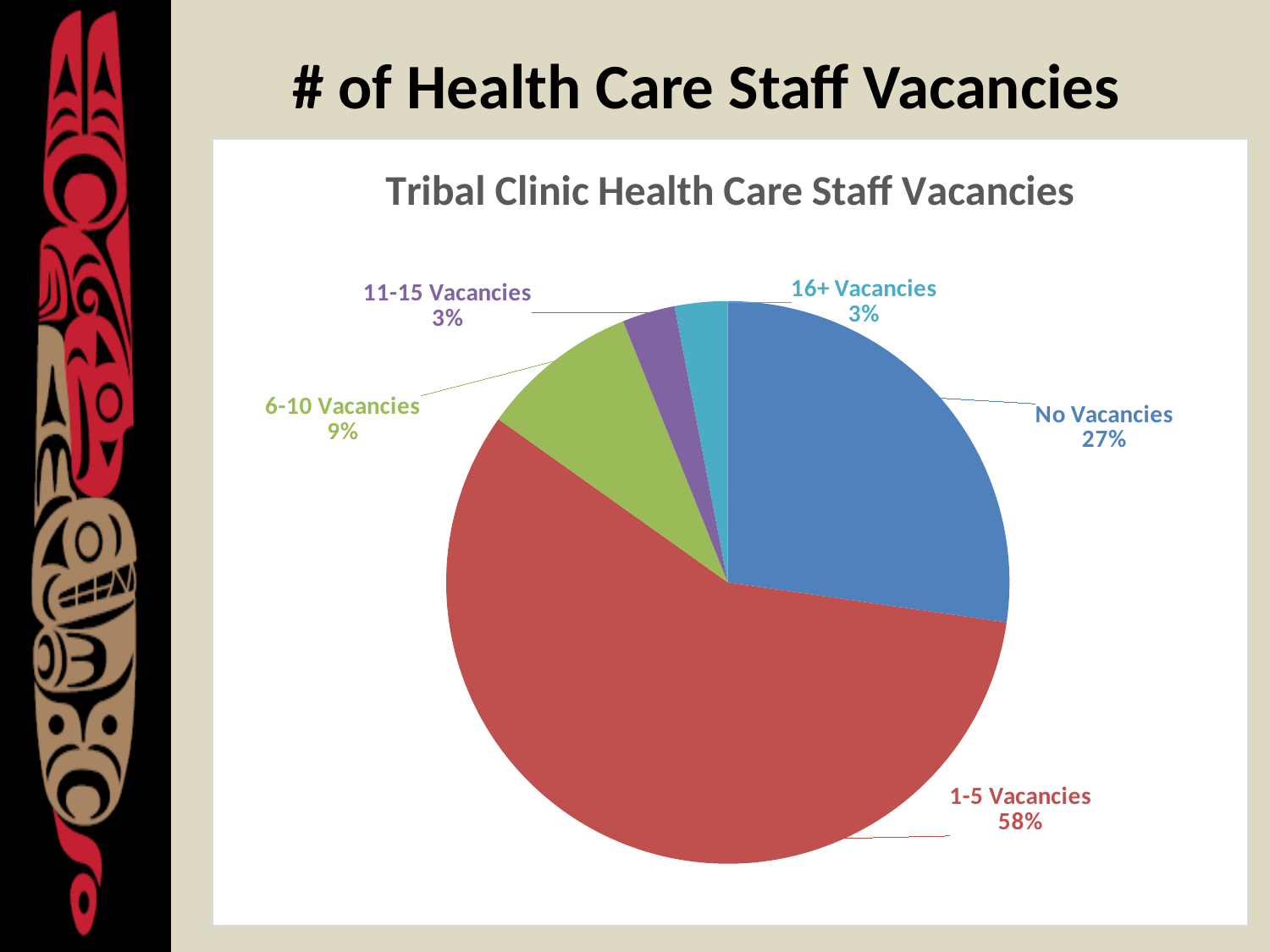
What colour is the 1-5 Vacancies slice? Red What percentage is shown for 6-10 Vacancies? 9% What share of the pie does the 1-5 Vacancies slice represent? 58% How many categories are shown in the pie chart? 5 What percentage is shown for 11-15 Vacancies? 3% What percentage is shown for 16+ Vacancies? 3% What is the title of the chart? Tribal Clinic Health Care Staff Vacancies What percentage is shown for No Vacancies? 27% Which category has the largest slice of the pie? 1-5 Vacancies What kind of chart is shown on the slide? Pie chart Which is larger, the share for No Vacancies or the share for 6-10 Vacancies? No Vacancies What is the difference in percentage points between 1-5 Vacancies and No Vacancies? 31